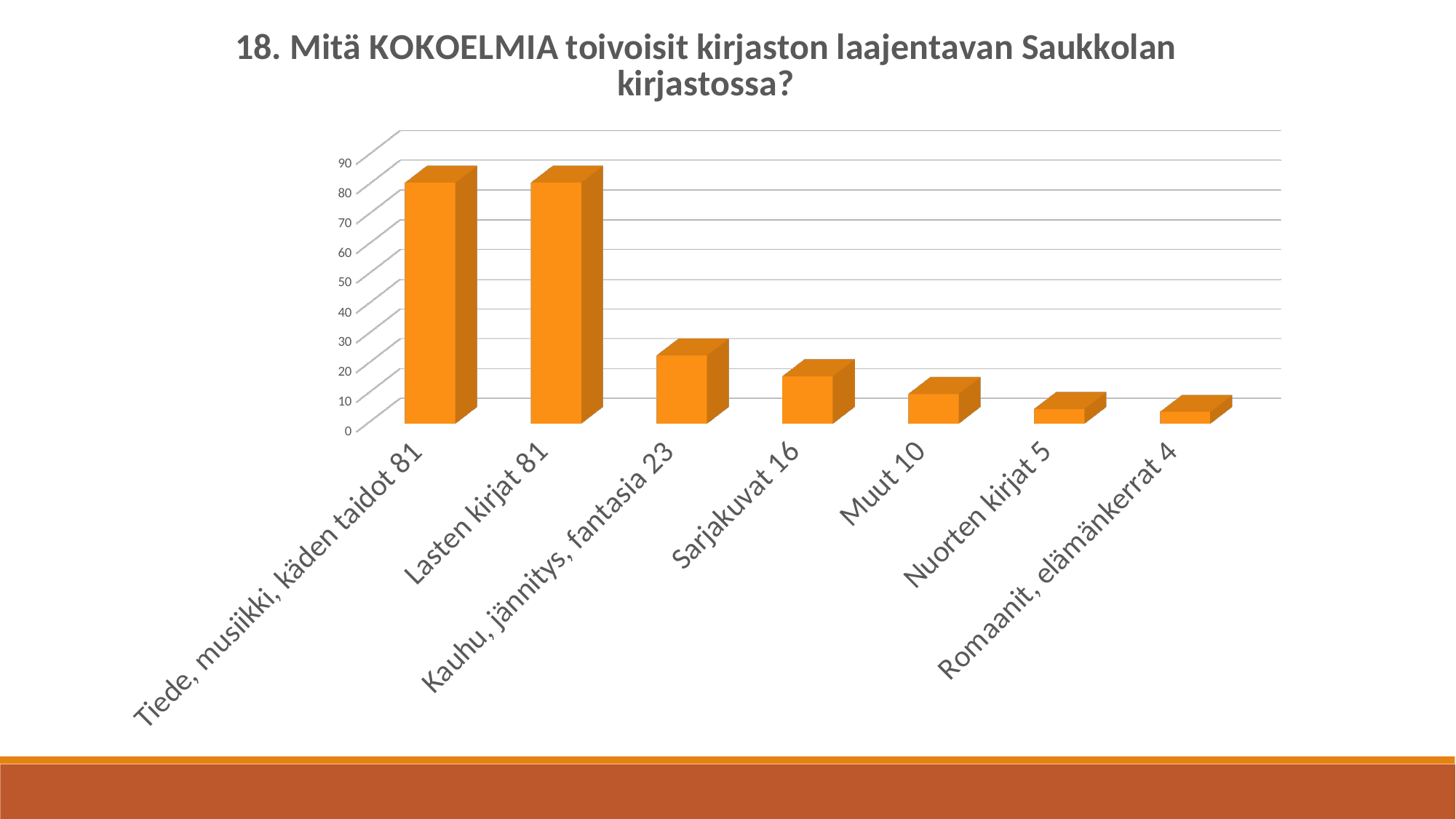
Which category has the lowest value? Romaanit, elämänkerrat What kind of chart is shown on the slide? bar chart Which is larger, the value for Sarjakuvat or the value for Muut? Sarjakuvat What is the value for Muut? 10 Is the value for Lasten kirjat greater or less than 70? greater How many categories are shown in the chart? 7 What is the value for Kauhu, jännitys, fantasia? 23 What is the difference between the values for Kauhu, jännitys, fantasia and Sarjakuvat? 7 What is the value for Nuorten kirjat? 5 Do the values rise or fall from left to right along the x axis? fall What is the value for Sarjakuvat? 16 What is the difference between the values for Lasten kirjat and Muut? 71